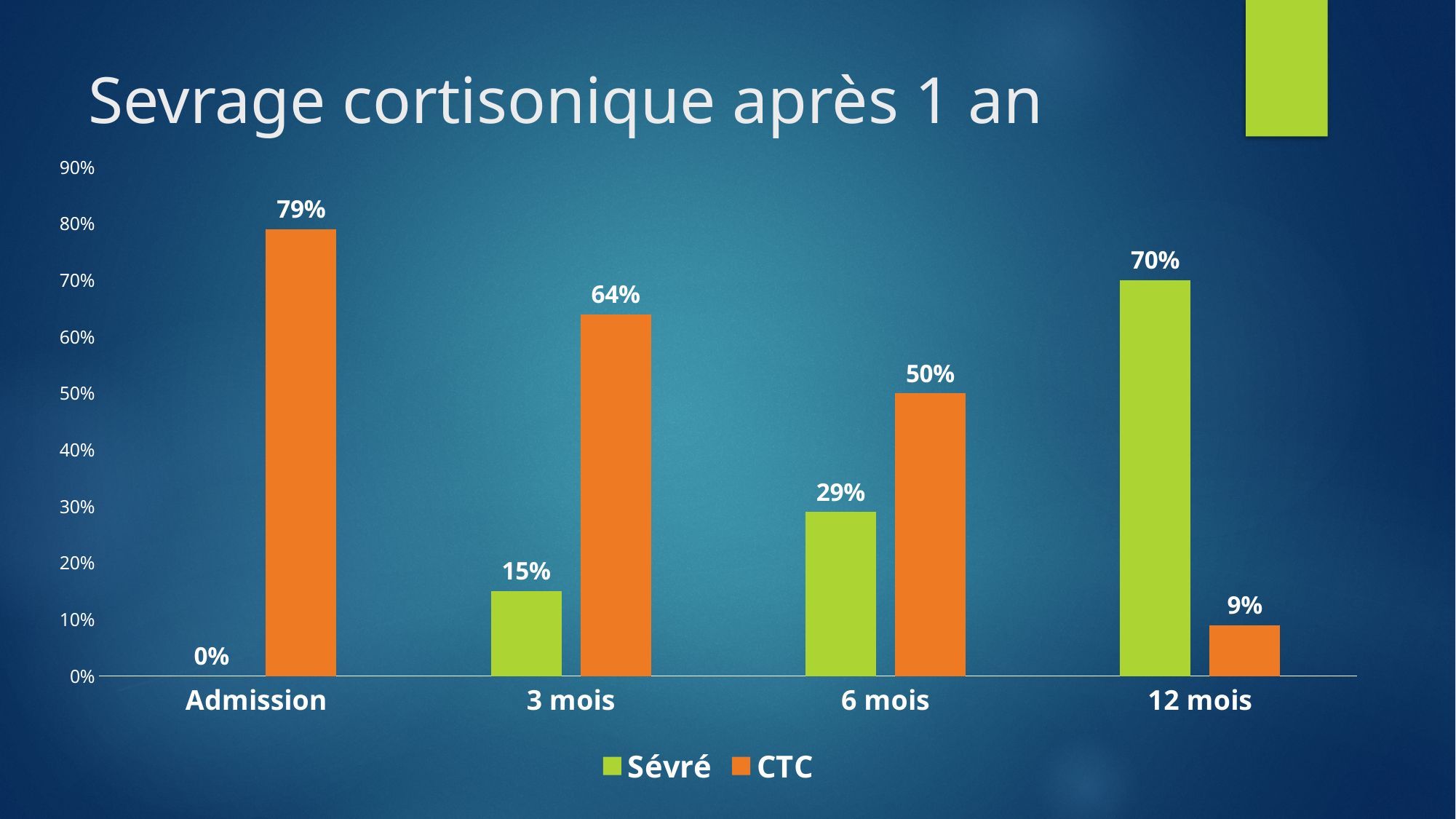
What is the value for Sévré at 3 mois? 15% At 12 mois, which is larger: Sévré or CTC? Sévré What is the difference between the CTC and Sévré values at 6 mois? 21% At which time point is the Sévré value lowest? Admission How many time points are shown on the x axis? 4 Do the CTC values rise or fall from Admission to 12 mois? Fall How many series does the legend list? 2 At which time point is the CTC value highest? Admission What is the value for Sévré at 12 mois? 70% What kind of chart is shown on the slide? Bar chart What is the value for CTC at Admission? 79% What is the value for CTC at 6 mois? 50%